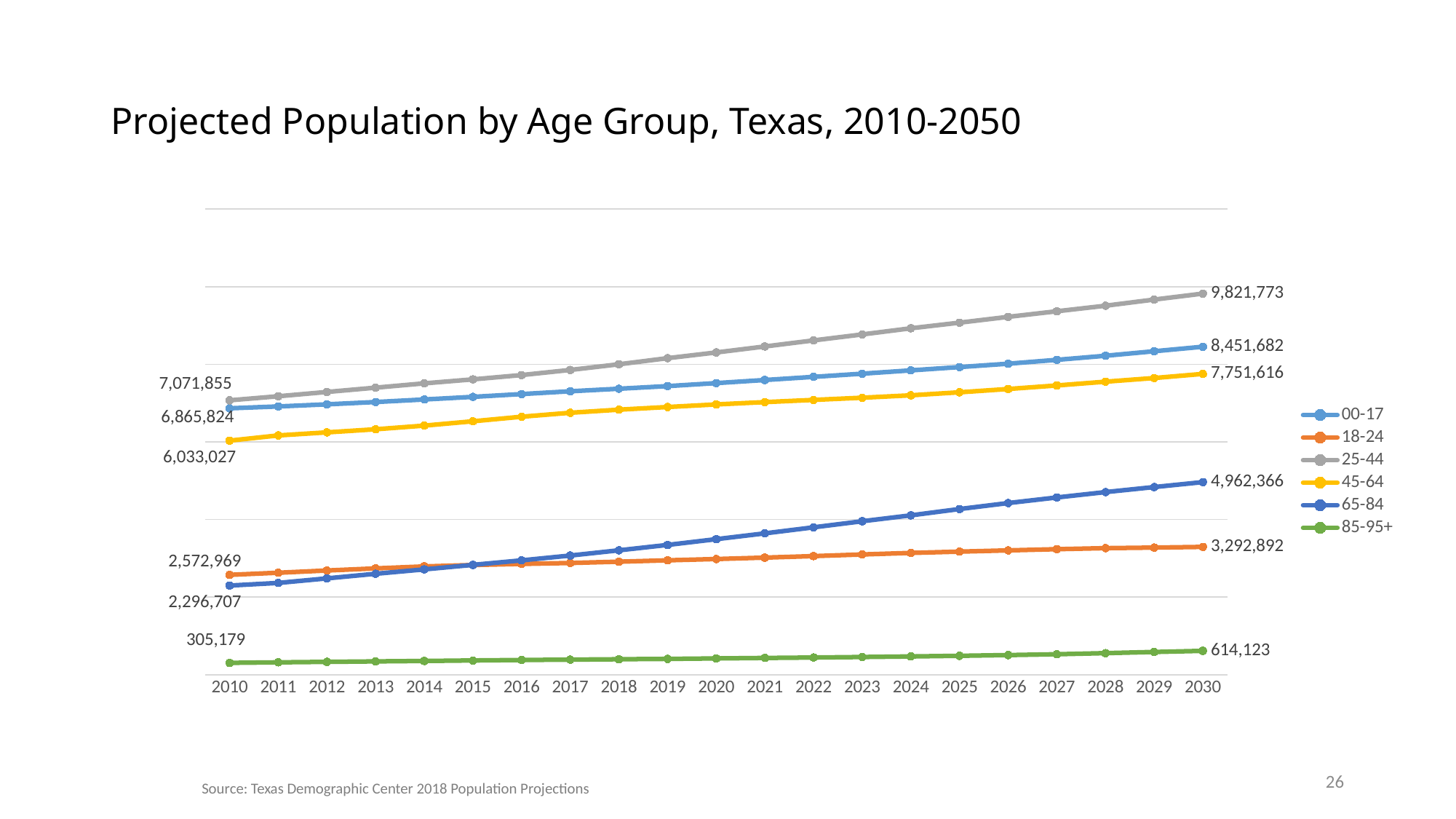
Which age group has the lowest projected population in 2010? 85-95+ By how much does the projected population of the 25-44 age group increase from 2010 to 2030? 2,749,918 What is the projected population for the 25-44 age group in 2030? 9,821,773 In 2030, which is larger: the projected population of the 65-84 age group or the 18-24 age group? 65-84 What is the projected population for the 65-84 age group in 2030? 4,962,366 By how much does the projected population of the 85-95+ age group increase from 2010 to 2030? 308,944 What kind of chart is shown on the slide? Line chart Which age group has the highest projected population in 2030? 25-44 What is the projected population for the 85-95+ age group in 2010? 305,179 How many series does the legend list? 6 What is the projected population for the 45-64 age group in 2010? 6,033,027 Does the projected population of the 65-84 age group rise or fall from 2010 to 2030? Rise